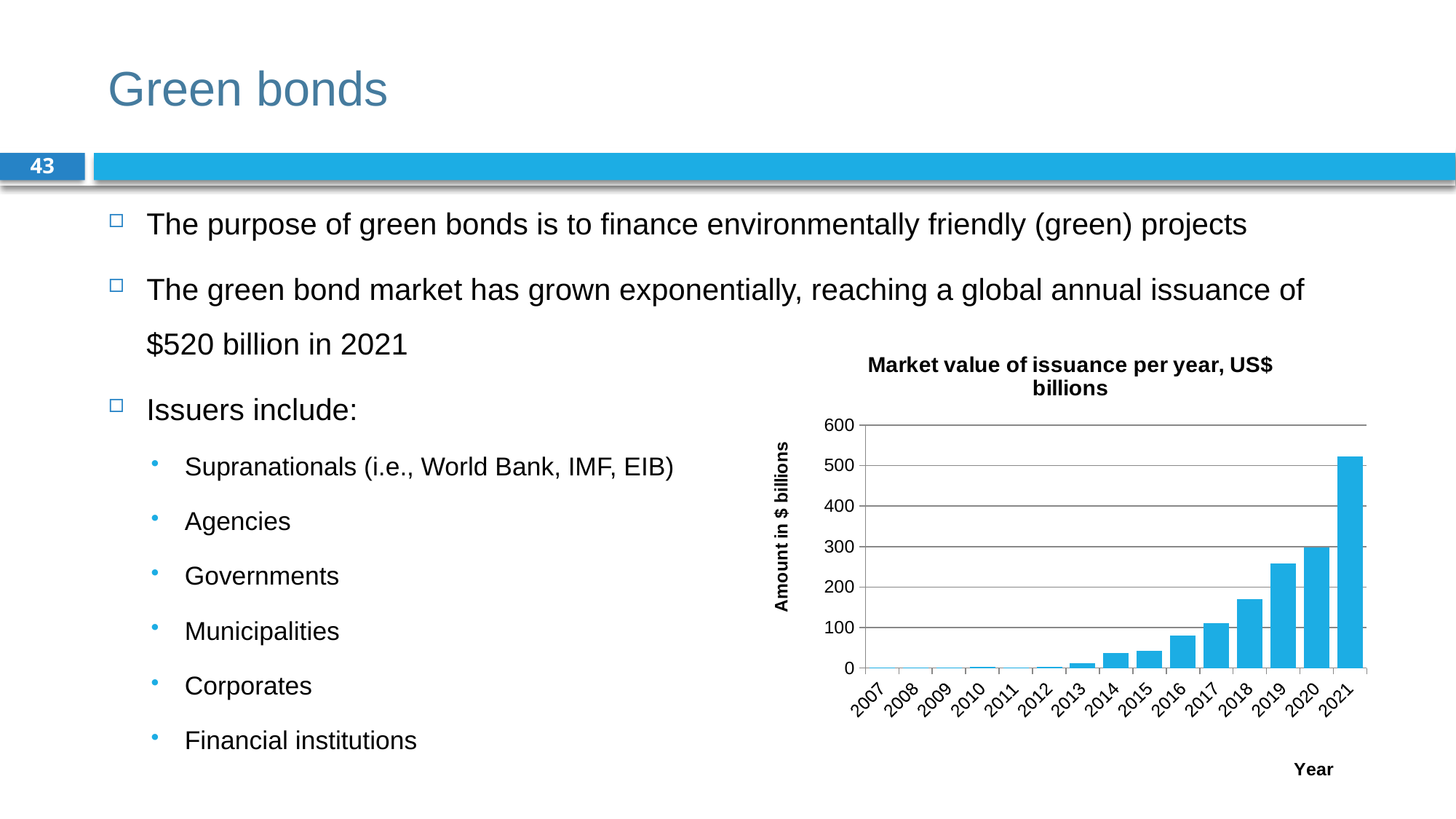
What is the label on the vertical axis of the chart? Amount in $ billions How many years are shown on the x axis of the chart? 15 Which year has the larger value, 2016 or 2019? 2019 Do the values generally rise or fall from 2007 to 2021? Rise Is the value for 2018 greater or less than 200? less What kind of chart is shown on the slide? Bar chart Is the value for 2016 greater or less than 100? less Which year has the highest market value of issuance? 2021 Is the value for 2021 greater or less than 500? greater Which year has the larger value, 2020 or 2021? 2021 What is the title of the chart? Market value of issuance per year, US$ billions